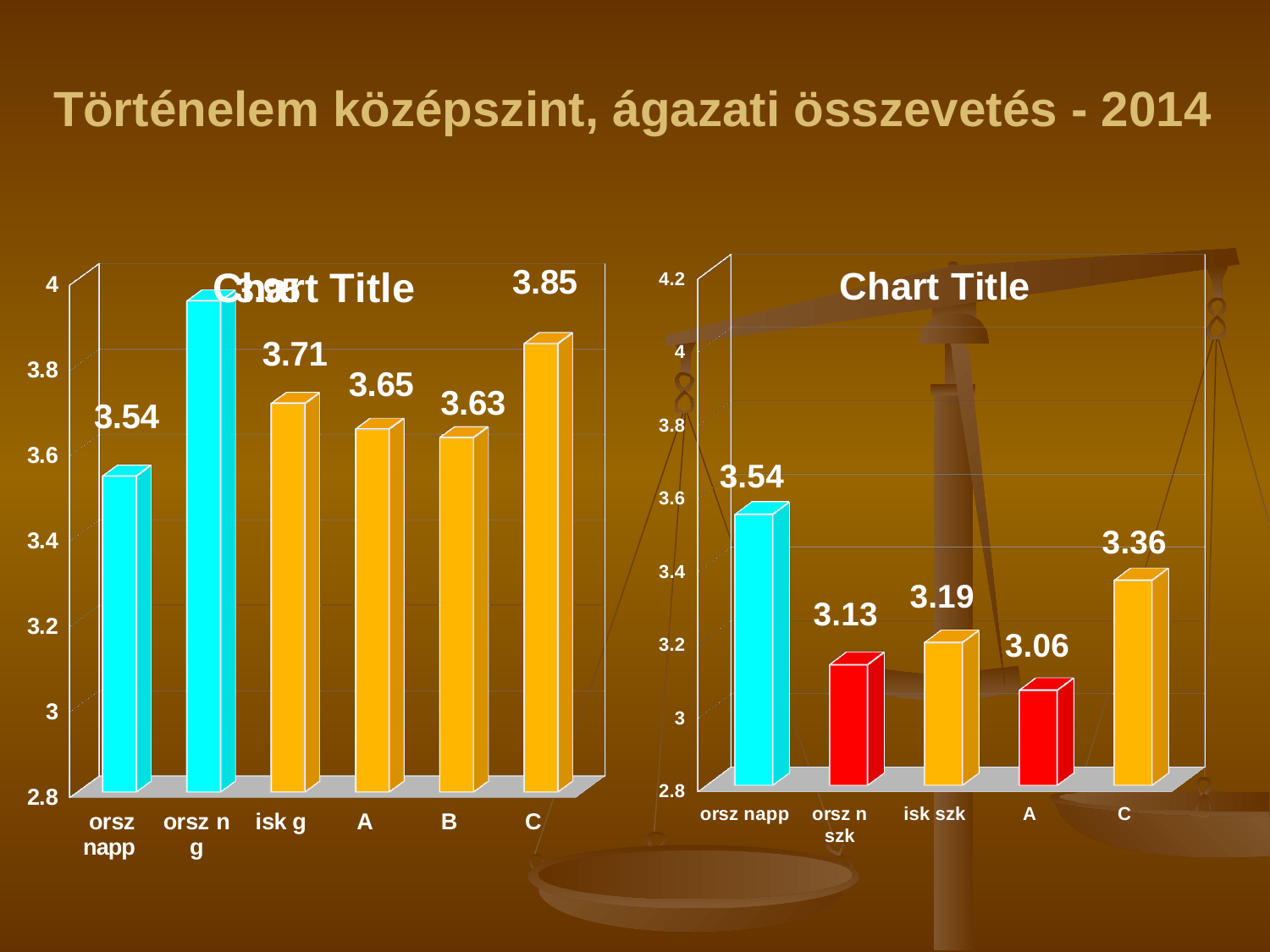
On the left chart, what is the value for isk g? 3.71 On the right chart, which category has the lowest value? A On the left chart, what is the difference between the values for C and B? 0.22 On the left chart, which category has the highest bar? orsz n g How many categories are shown on the right chart? 5 On the right chart, which is larger, the value for isk szk or the value for C? C On the right chart, which category has the highest value? orsz napp On the left chart, which category has the lowest value? orsz napp On the left chart, what is the value for C? 3.85 On the left chart, is the value for orsz n g greater or less than 3.8? greater On the right chart, what is the value for orsz n szk? 3.13 What type of chart is the left chart? bar chart